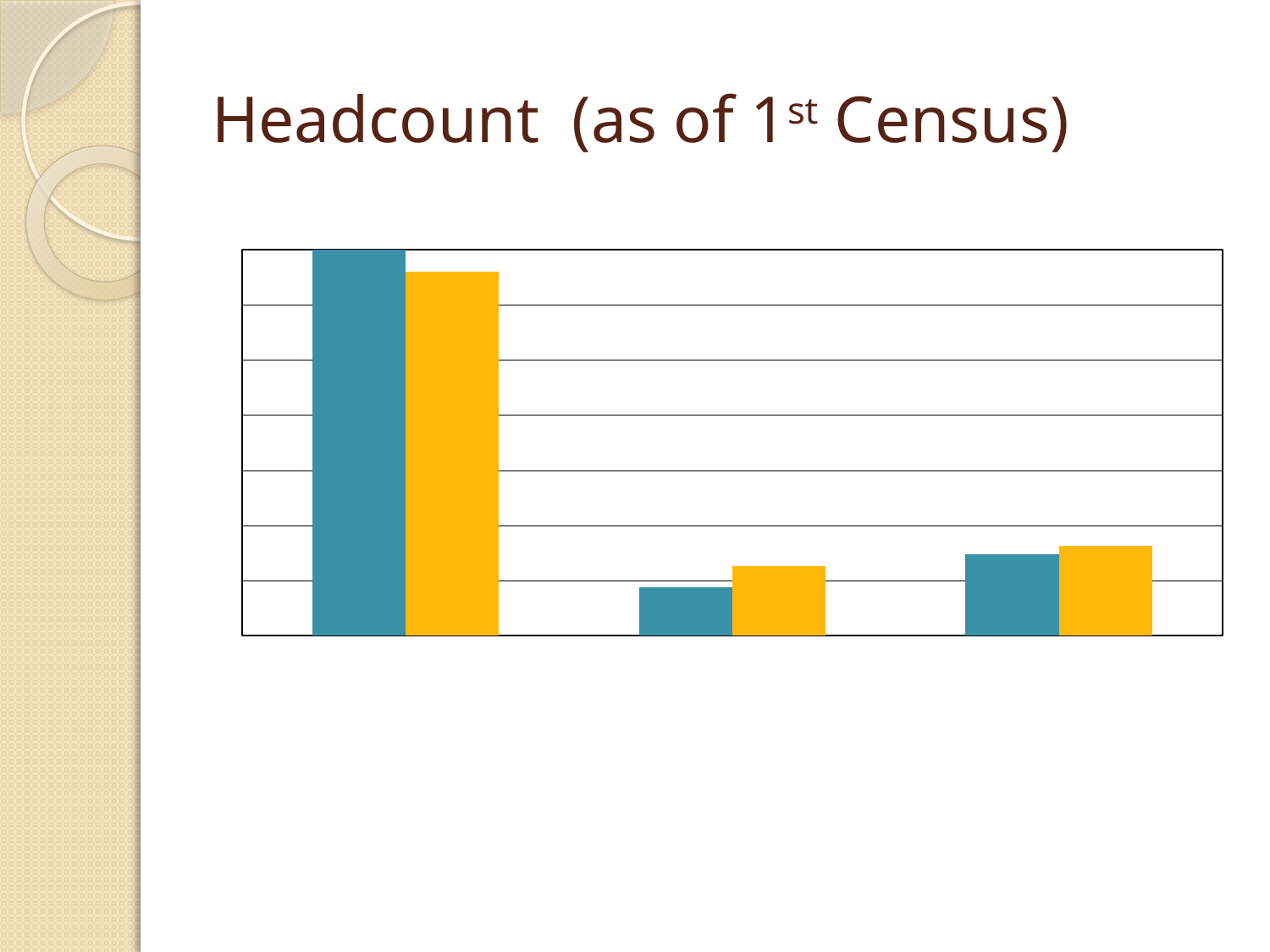
How many bars are in each group on the chart? 2 In the leftmost group, which bar is taller, the blue one or the orange one? blue In the rightmost group, which bar is taller, the blue one or the orange one? orange Which group of bars is the tallest: the leftmost, middle, or rightmost? leftmost How many bars are plotted in total on the chart? 6 What kind of chart is shown on the slide? bar chart In the middle group, which bar is taller, the blue one or the orange one? orange How many groups of bars does the chart show? 3 What two colours are used for the bars in the chart? blue and orange Which group of bars is the shortest: the leftmost, middle, or rightmost? middle What is the title of the slide containing the chart? Headcount (as of 1st Census)